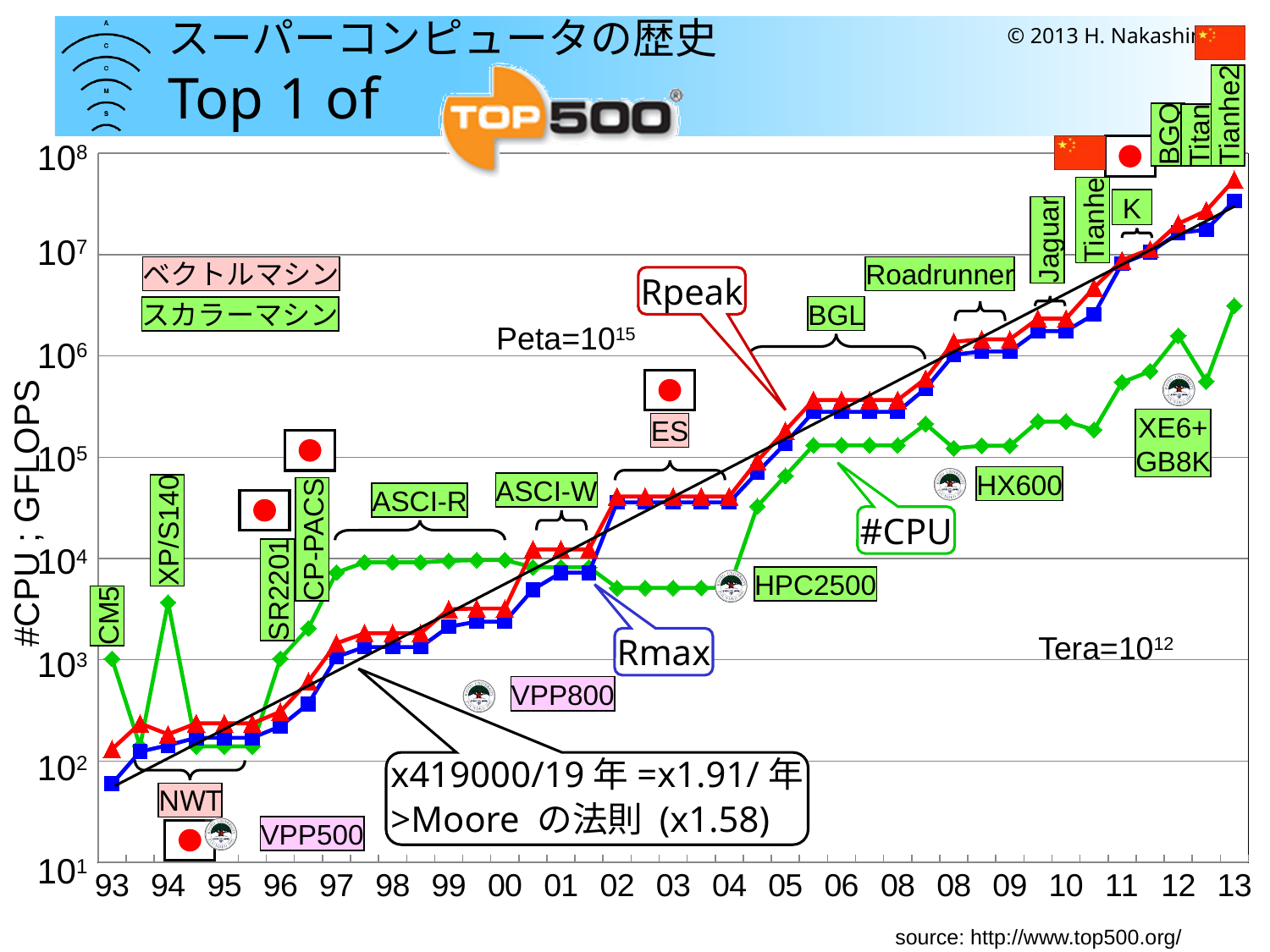
What kind of chart is shown on the slide? line chart Is the value for Rpeak in 13 greater or less than 10^7? greater Is the value for #CPU in 13 greater or less than 10^7? less What are the names of the three series plotted on the chart? Rpeak, Rmax, #CPU Does the Rmax series generally rise or fall from 93 to 13? rise In 13, which series has the larger value, Rpeak or #CPU? Rpeak Is the value for #CPU in 94 greater or less than 10^3? greater In 94, which series has the larger value, #CPU or Rmax? #CPU What is the label of the y axis? #CPU ; GFLOPS How many data series are plotted on the chart? 3